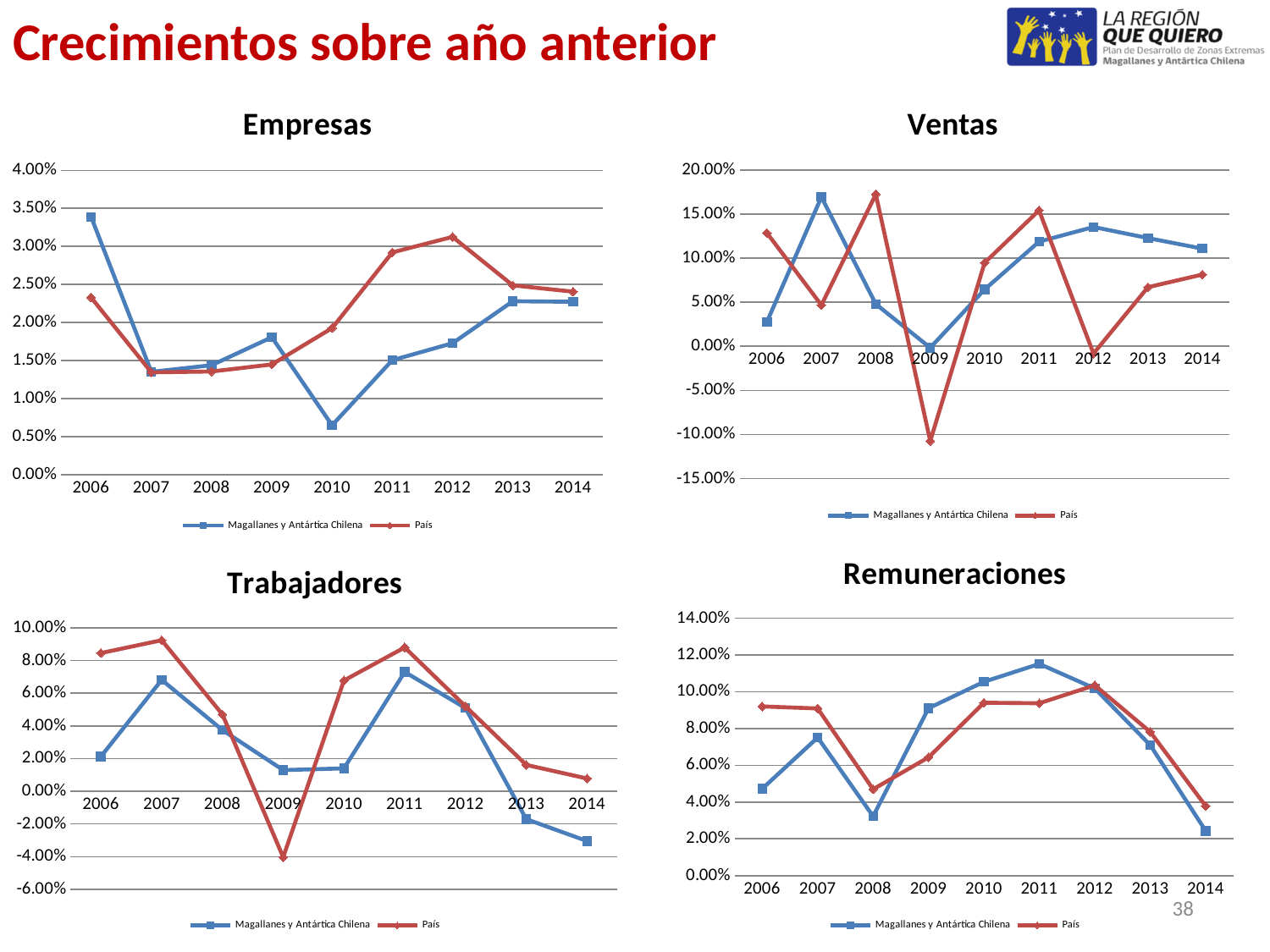
What kind of chart is the Empresas chart? line chart In the Ventas chart, in which year is the Magallanes y Antártica Chilena series at its highest? 2007 In the Trabajadores chart, in which year is the País series at its lowest? 2009 How many series does the legend of the Ventas chart list? 2 How many years are plotted on the x axis of the Empresas chart? 9 In the Ventas chart, is the value for País in 2009 greater or less than -5.00%? less In the Empresas chart, is the value for Magallanes y Antártica Chilena in 2010 greater or less than 1.00%? less In the Trabajadores chart, which series has the larger value in 2007, Magallanes y Antártica Chilena or País? País In the Empresas chart, is the value for Magallanes y Antártica Chilena in 2006 greater or less than 3.00%? greater In the Remuneraciones chart, in which year is the Magallanes y Antártica Chilena series at its highest? 2011 In the Ventas chart, in which year is the País series at its lowest? 2009